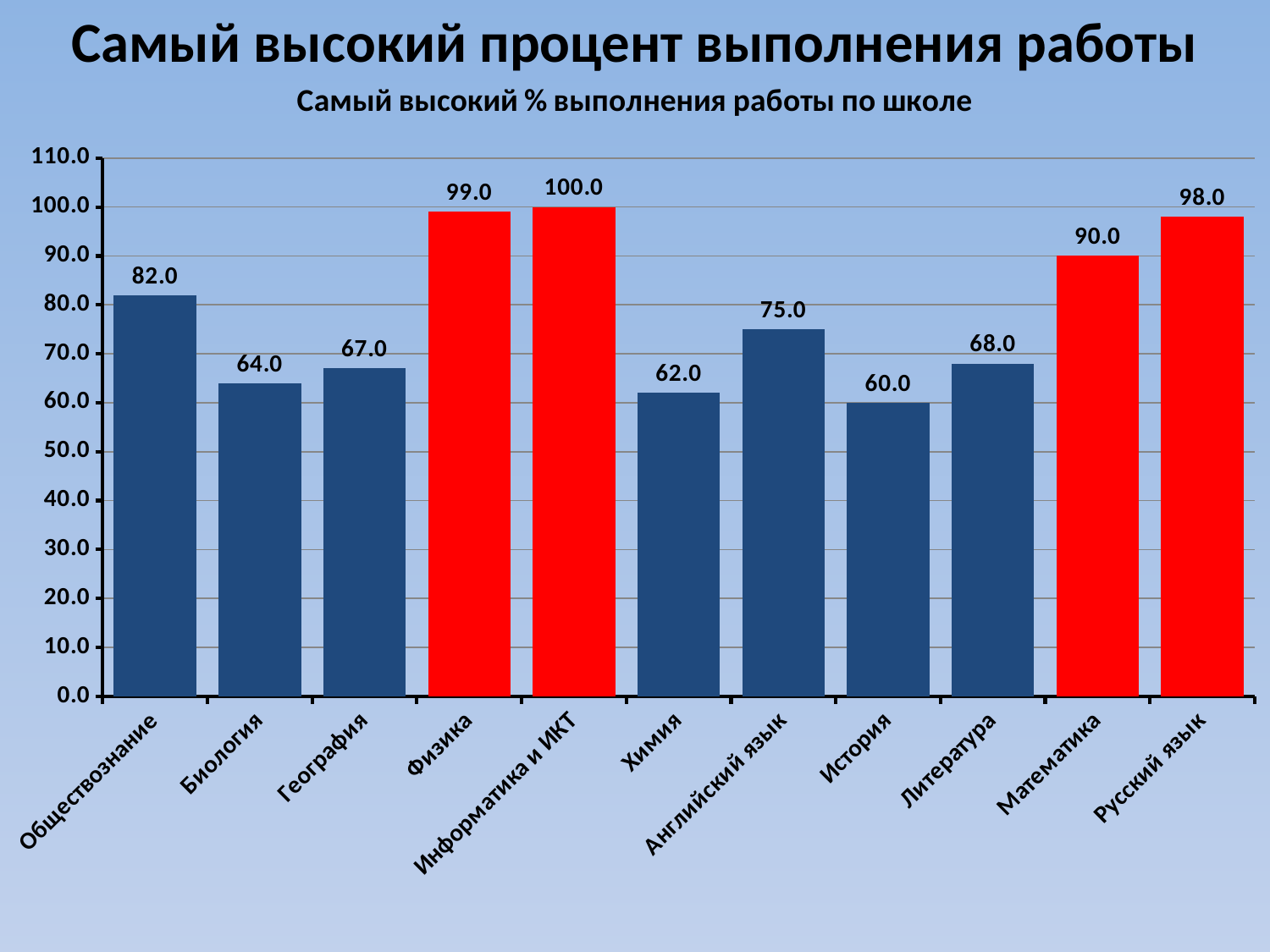
Which category has the highest value? Информатика и ИКТ What is the title of the chart? Самый высокий % выполнения работы по школе Which is larger, the value for Обществознание or the value for Литература? Обществознание Is the value for Биология greater or less than 70.0? less What kind of chart is shown on the slide? bar chart What is the value for Английский язык? 75.0 How many categories are shown on the x axis? 11 What is the difference between the values for Русский язык and Математика? 8.0 How many bars are coloured red? 4 What is the value for Физика? 99.0 Which category has the lowest value? История What is the value for История? 60.0